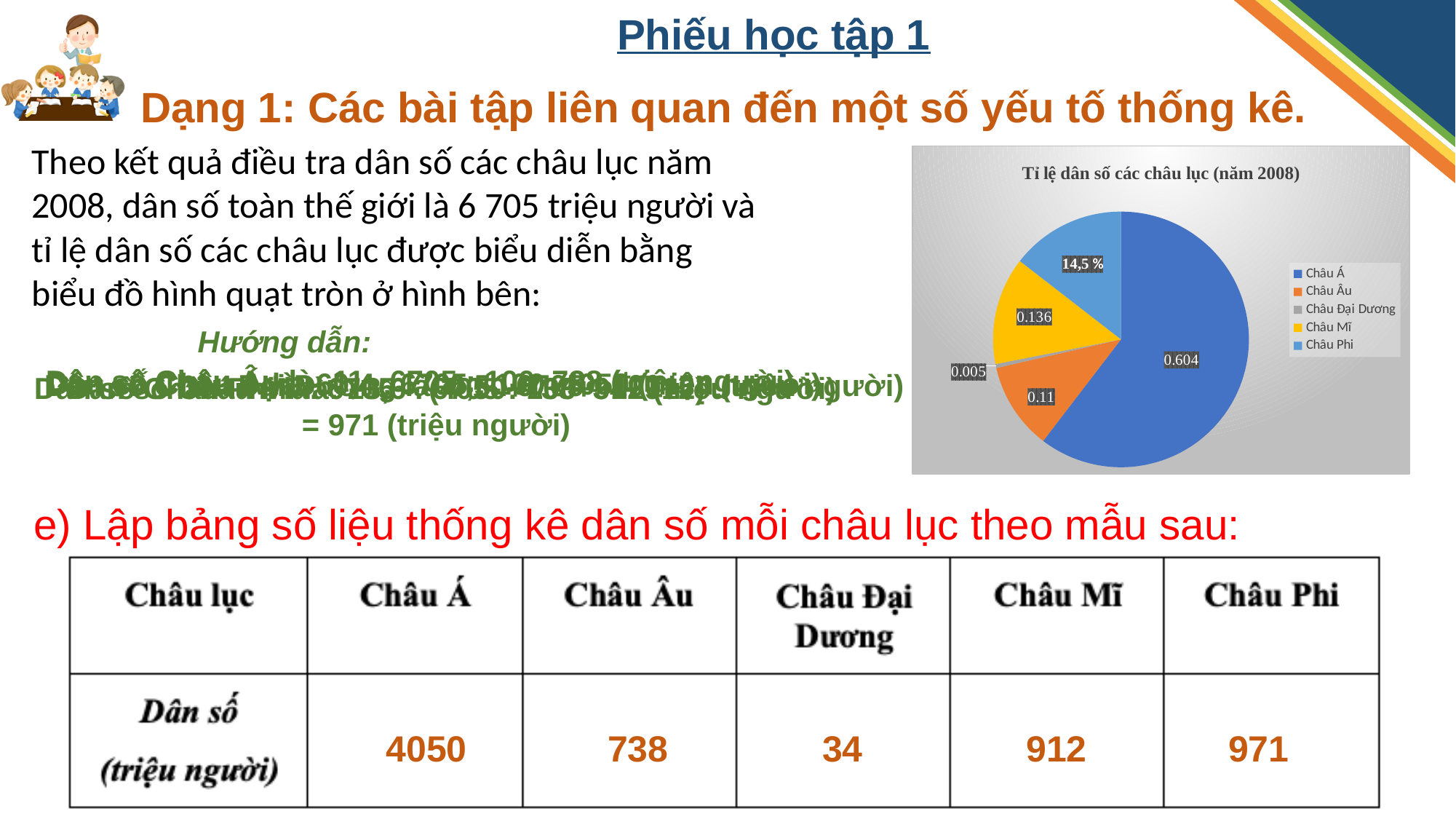
What type of chart is shown on the slide? pie chart How many slices does the pie chart have? 5 What value is labelled on the Châu Đại Dương slice of the pie chart? 0.005 What value is labelled on the Châu Âu slice of the pie chart? 0.11 What value is labelled on the Châu Mĩ slice of the pie chart? 0.136 Which slice is larger in the pie chart, Châu Mĩ or Châu Âu? Châu Mĩ Which continent has the smallest slice in the pie chart? Châu Đại Dương How many entries does the legend of the pie chart list? 5 Which continent has the largest slice in the pie chart? Châu Á What value is labelled on the Châu Á slice of the pie chart? 0.604 What is the title of the chart? Tỉ lệ dân số các châu lục (năm 2008) What value is labelled on the Châu Phi slice of the pie chart? 14,5 %